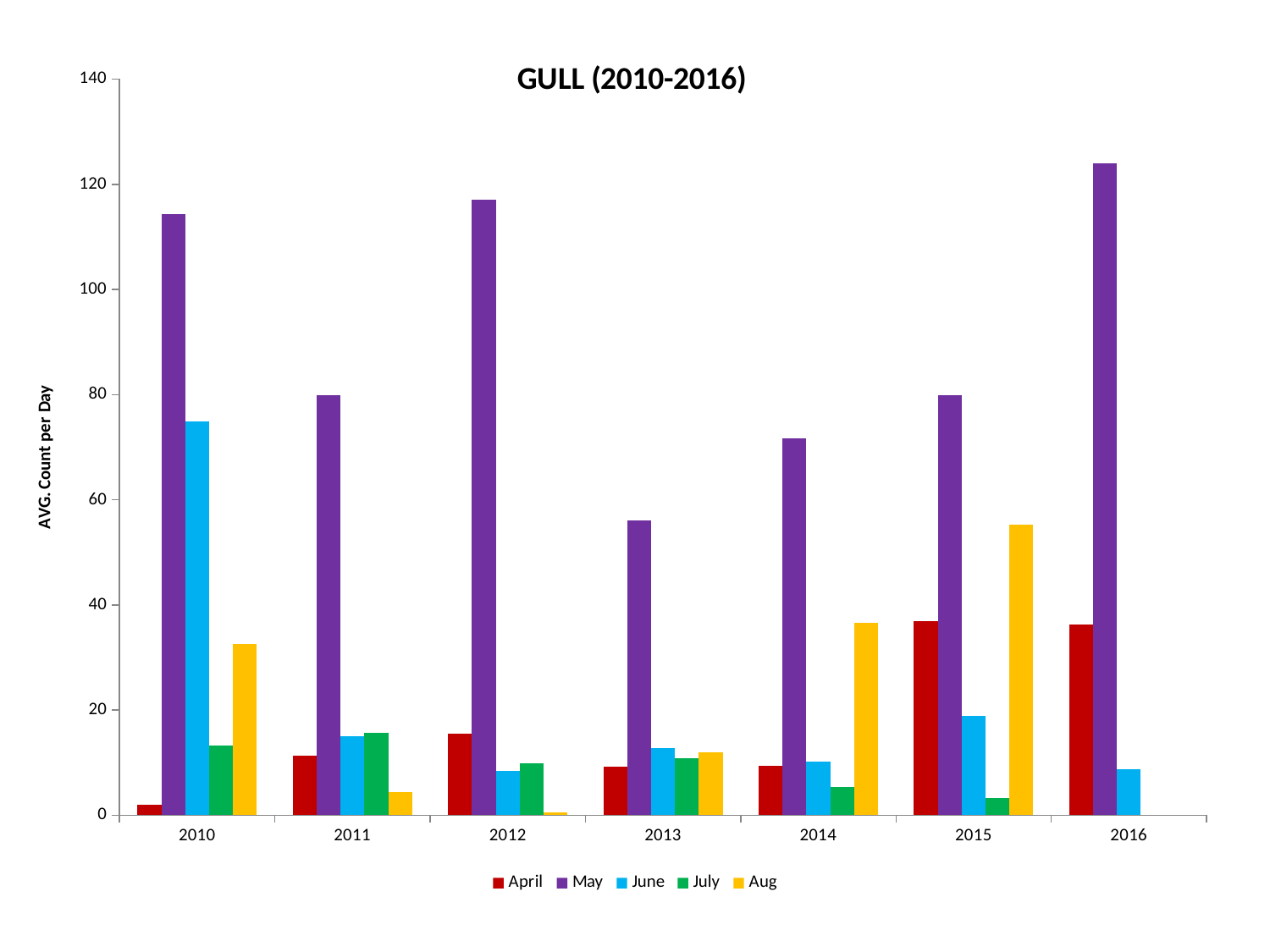
What is the title of the y axis? AVG. Count per Day How many years are shown on the x axis? 7 How many series does the legend list? 5 Is the Aug value for 2015 greater or less than 40? greater Which is larger, the April value for 2010 or the April value for 2015? 2015 Is the June value for 2010 greater or less than 60? greater Which year has the highest May value? 2016 Do the May values rise or fall from 2013 to 2016? rise What kind of chart is shown on the slide? bar chart Is the May value for 2010 greater or less than 100? greater Which year has the lowest May value? 2013 Which is larger, the Aug value for 2014 or the Aug value for 2015? 2015